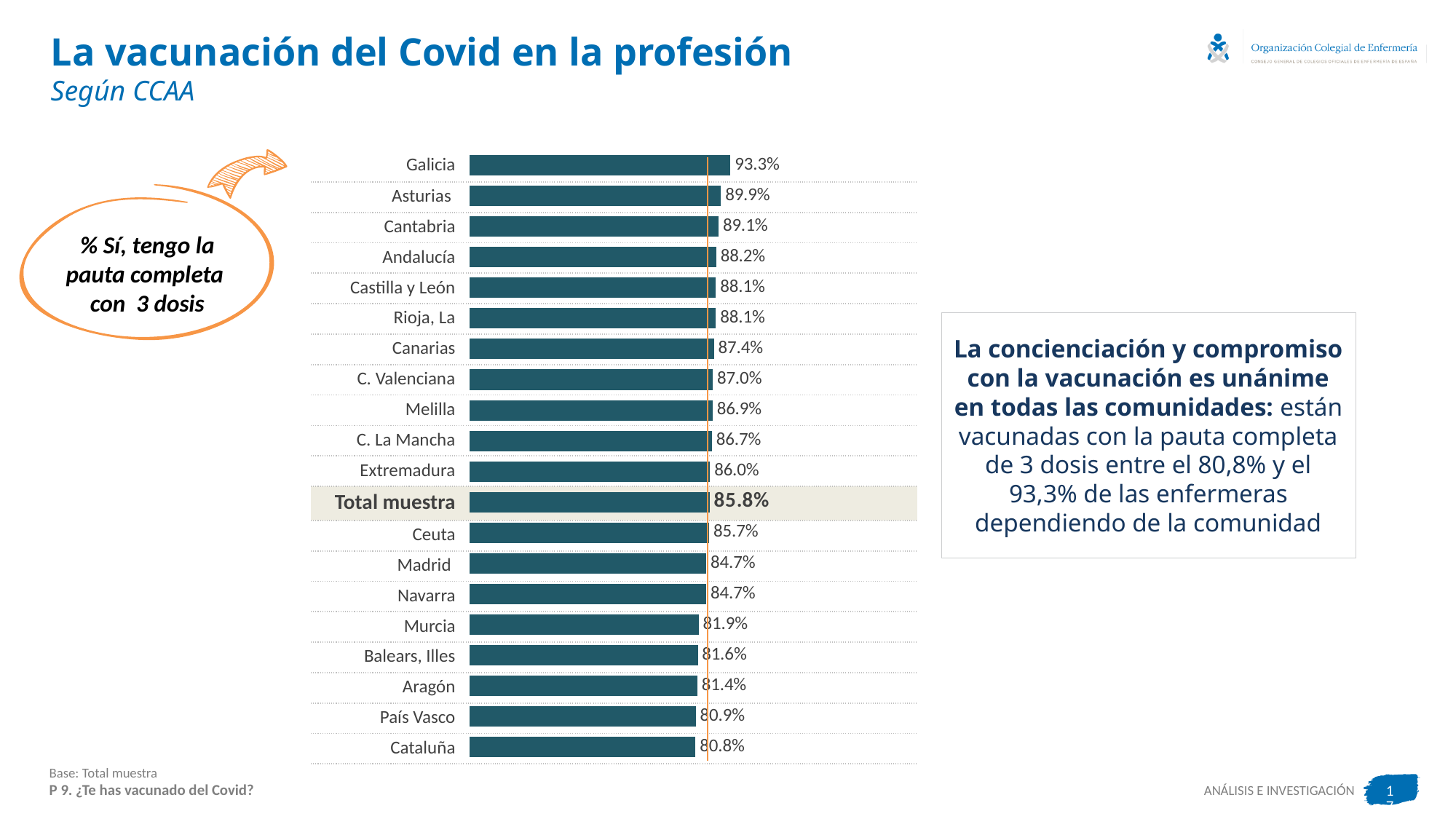
What is the difference between the values for Asturias and Madrid? 5.2% What is the value for Galicia? 93.3% According to the callout bubble, what do the bars represent? % Sí, tengo la pauta completa con 3 dosis What is the value for Melilla? 86.9% What is the value for Total muestra? 85.8% How many categories (bars) are shown in the chart? 20 Which is larger, the value for Canarias or the value for Murcia? Canarias What is the value for Cataluña? 80.8% Which category has the lowest value? Cataluña What kind of chart is shown on the slide? Bar chart Which category has the highest value? Galicia What is the difference between the values for Galicia and Cataluña? 12.5%